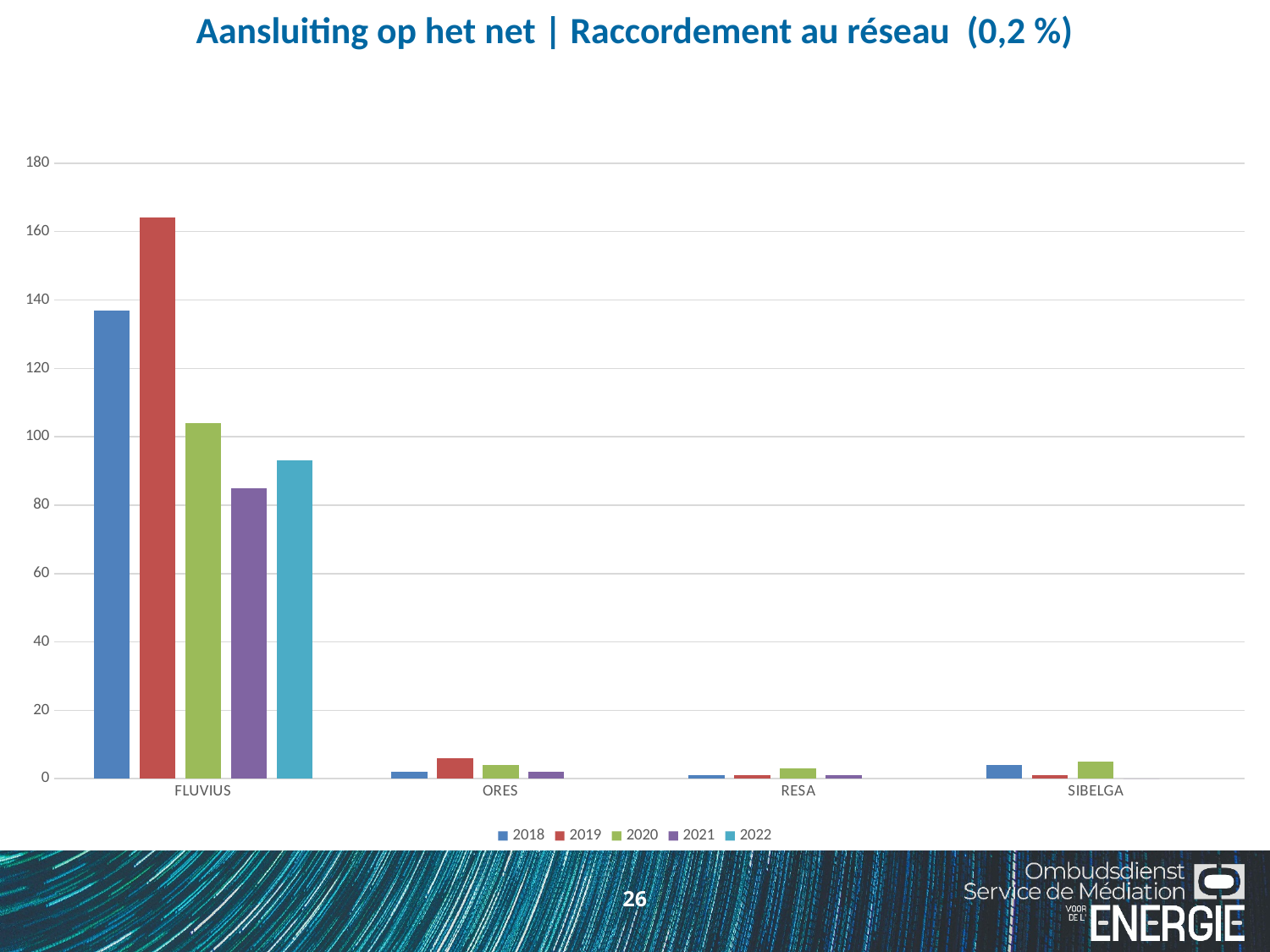
Is the value for FLUVIUS in 2022 greater or less than 100? less For FLUVIUS, which is larger: the value for 2020 or the value for 2022? 2020 How many categories are shown on the x axis? 4 For FLUVIUS, which year has the highest bar? 2019 For FLUVIUS, which year has the lowest bar? 2021 Is the value for FLUVIUS in 2019 greater or less than 140? greater What is the title of the chart? Aansluiting op het net | Raccordement au réseau (0,2 %) What kind of chart is shown on the slide? bar chart Is the value for FLUVIUS in 2021 greater or less than 100? less Which category has the highest values overall? FLUVIUS How many series does the legend list? 5